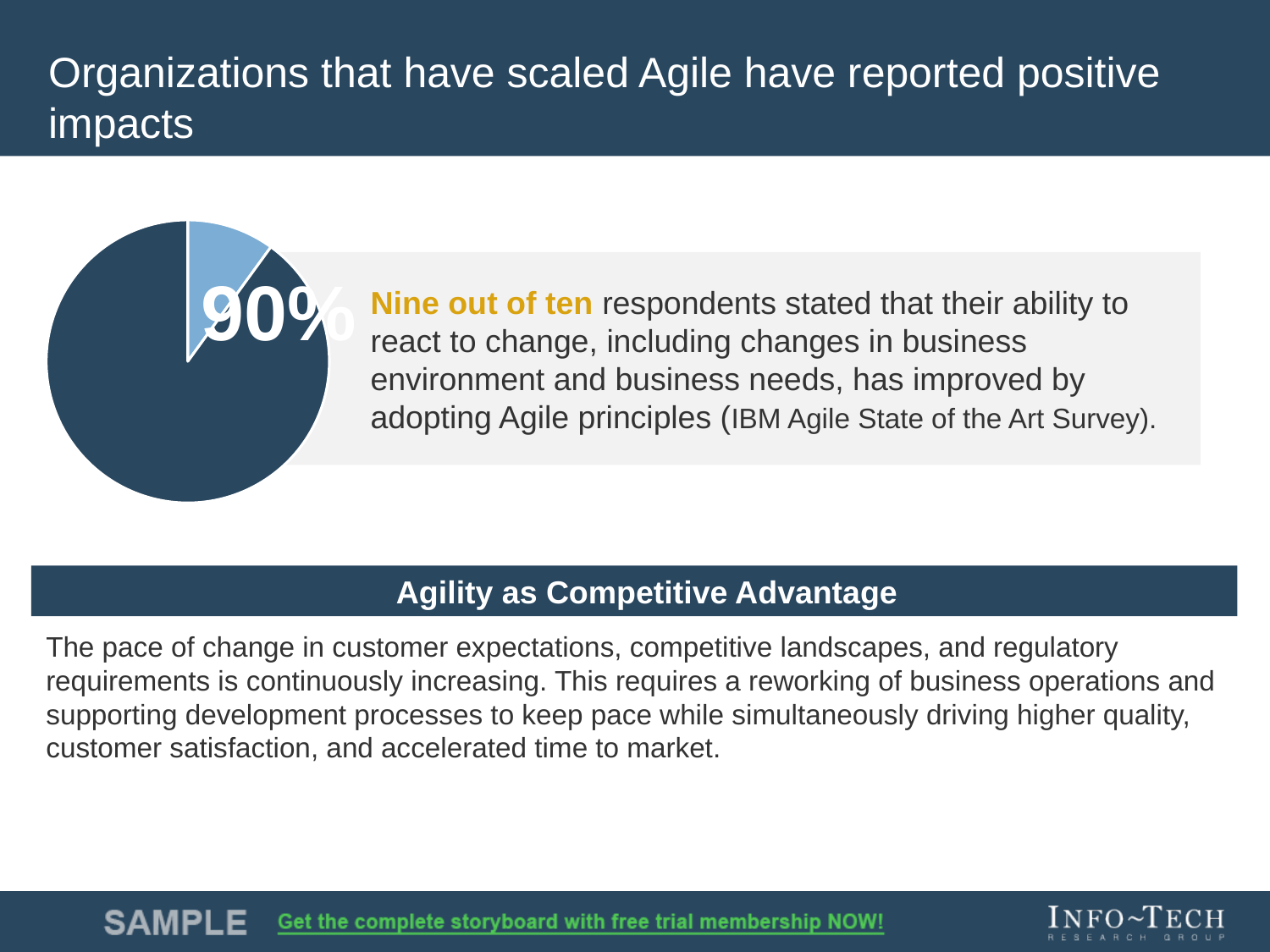
What percentage is printed on the pie chart? 90% What kind of chart is shown on the slide? pie chart How many slices does the pie chart have? 2 Which slice of the pie chart is larger, the dark blue slice or the light blue slice? the dark blue slice Is the share of the light blue slice in the pie chart greater or less than 25%? less What colour is the larger slice of the pie chart? dark blue What share of the pie does the dark blue slice represent? 90% Is the share of the dark blue slice in the pie chart greater or less than 50%? greater Which survey is cited as the source for the 90% figure shown next to the pie chart? IBM Agile State of the Art Survey